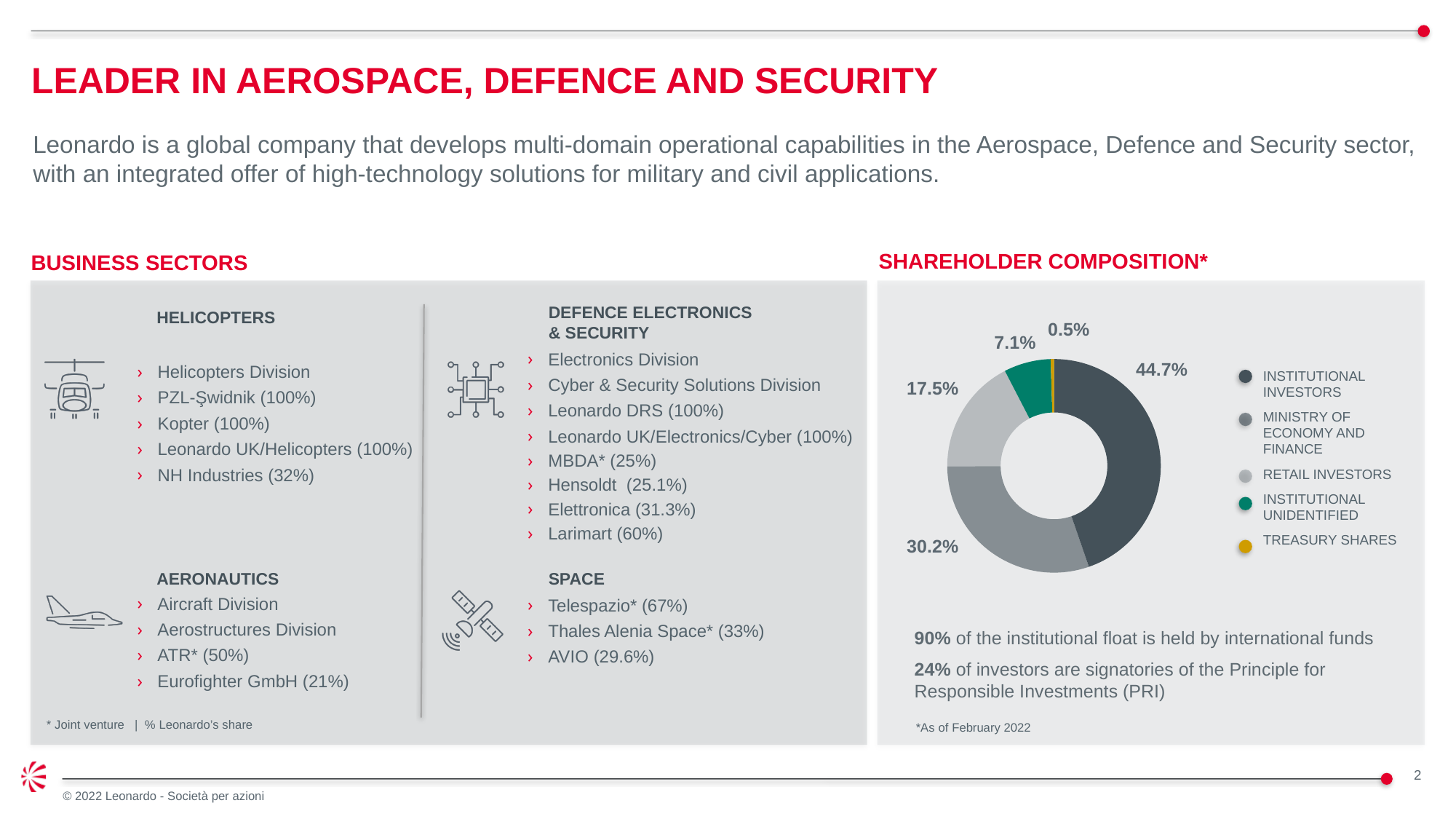
In the Shareholder Composition chart, which is larger: Retail Investors or Institutional Unidentified? Retail Investors What percentage does the Ministry of Economy and Finance hold according to the Shareholder Composition chart? 30.2% In the Shareholder Composition chart, what is the difference between the Institutional Investors share and the Ministry of Economy and Finance share? 14.5% What type of chart is used for the Shareholder Composition? Donut (pie) chart Which shareholder category has the largest share in the Shareholder Composition chart? Institutional Investors What share of shareholders are Institutional Investors in the Shareholder Composition chart? 44.7% How many shareholder categories are shown in the Shareholder Composition chart? 5 Which shareholder category has the smallest share in the Shareholder Composition chart? Treasury Shares Which colour represents Treasury Shares in the Shareholder Composition chart? Yellow/gold In the Shareholder Composition chart, what is the combined share of Institutional Unidentified and Treasury Shares? 7.6% What percentage is shown for Treasury Shares in the Shareholder Composition chart? 0.5% What is the share of Retail Investors in the Shareholder Composition chart? 17.5%